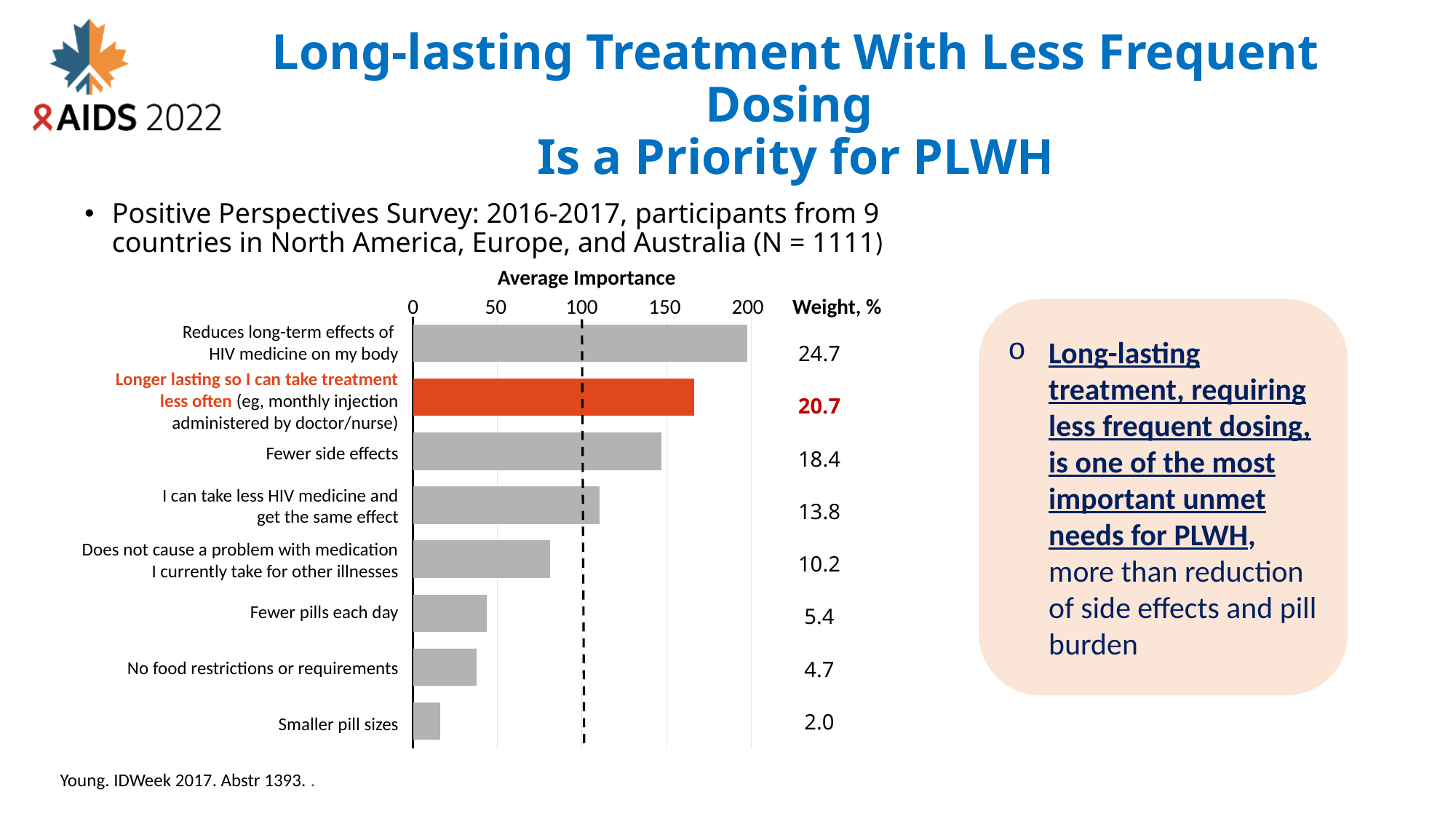
Which category's bar is highlighted in orange rather than grey? Longer lasting so I can take treatment less often Is the average importance for "Longer lasting so I can take treatment less often" greater or less than 150? greater Which category has the highest average importance? Reduces long-term effects of HIV medicine on my body What is the Weight, % for "Reduces long-term effects of HIV medicine on my body"? 24.7 Which category has the lowest average importance? Smaller pill sizes Is the average importance for "Does not cause a problem with medication I currently take for other illnesses" greater or less than 100? less What is the difference in Weight, % between "Reduces long-term effects of HIV medicine on my body" and "Longer lasting so I can take treatment less often"? 4.0 What kind of chart is shown on the slide? Bar chart What is the Weight, % for "Longer lasting so I can take treatment less often"? 20.7 How many categories (bars) does the chart show? 8 What is the Weight, % for "Fewer pills each day"? 5.4 Which has a higher Weight, %: "Fewer side effects" or "I can take less HIV medicine and get the same effect"? Fewer side effects